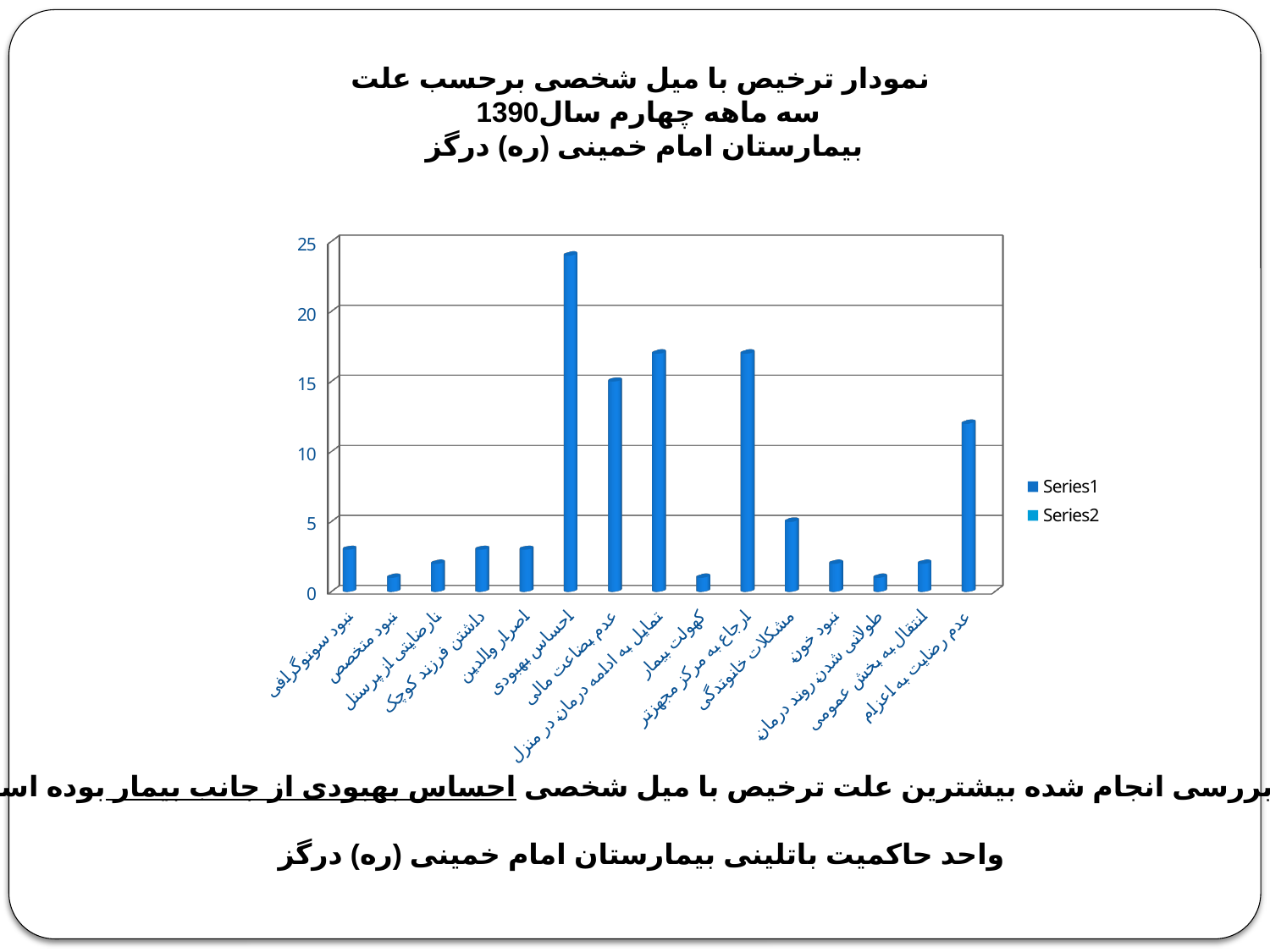
Is the value for عدم رضایت به اعزام greater or less than 10? greater What kind of chart is shown on the slide? bar chart Which is larger, the value for تمایل به ادامه درمان در منزل or the value for مشکلات خانوادگی? تمایل به ادامه درمان در منزل Is the value for احساس بهبودی greater or less than 20? greater Which category has the highest value in the chart? احساس بهبودی What year is mentioned in the chart title? 1390 How many series does the legend list? 2 Is the value for نبود سونوگرافی greater or less than 5? less How many categories are shown on the x axis of the chart? 15 What are the two entries listed in the chart legend? Series1, Series2 Which is larger, the value for احساس بهبودی or the value for عدم بضاعت مالی? احساس بهبودی